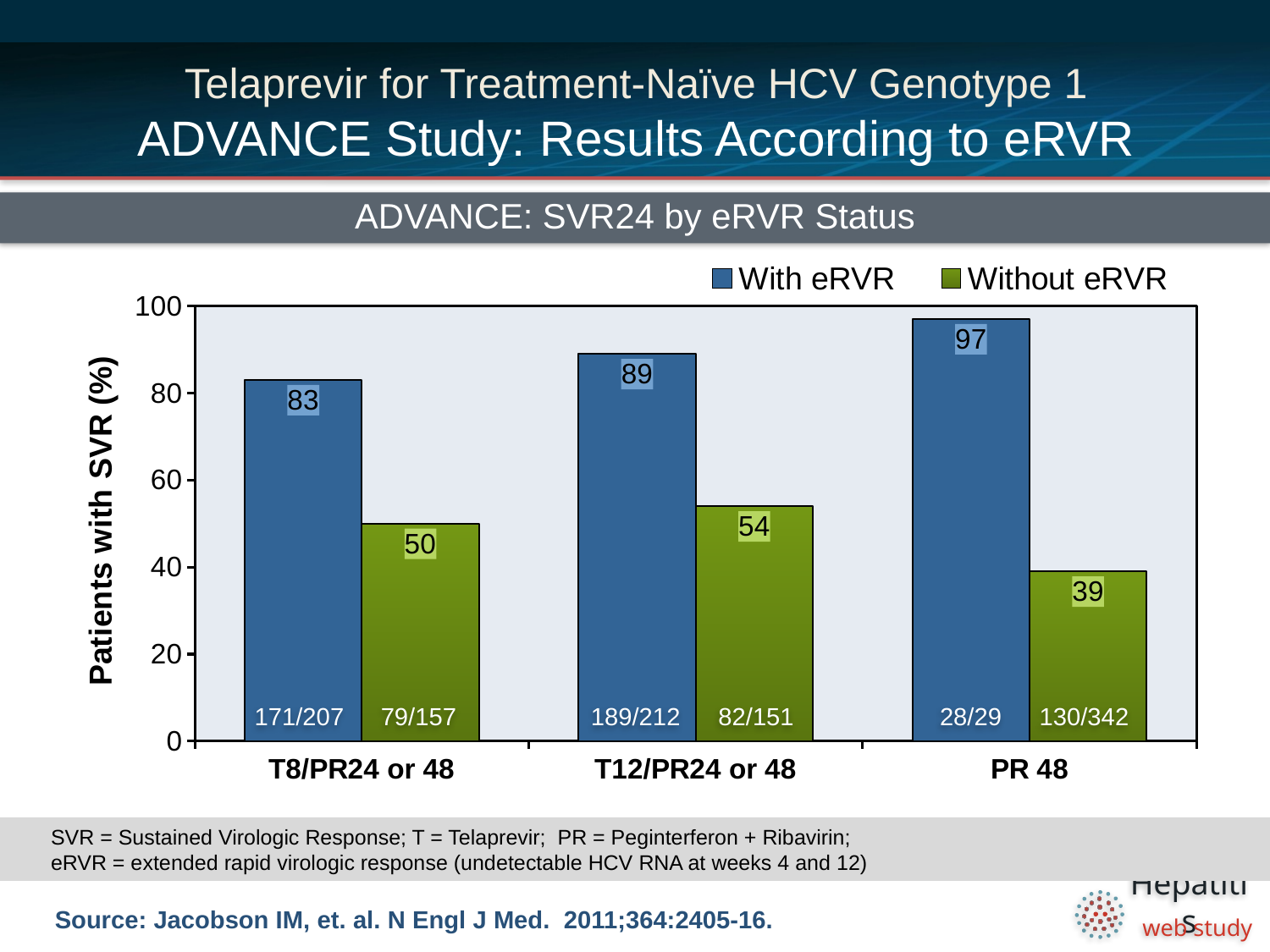
What is the SVR rate for patients with eRVR in the T12/PR24 or 48 group? 89 What is the title of the chart? ADVANCE: SVR24 by eRVR Status What is the difference between the With eRVR and Without eRVR SVR rates in the PR 48 group? 58 How many series does the legend list? 2 What fraction is printed on the With eRVR bar for the PR 48 group? 28/29 Which treatment group has the highest SVR rate among patients with eRVR? PR 48 Which is larger: the Without eRVR SVR rate for T8/PR24 or 48 or for T12/PR24 or 48? T12/PR24 or 48 How many treatment groups are shown on the x axis? 3 What kind of chart is shown on the slide? Bar chart What is the SVR rate for patients with eRVR in the T8/PR24 or 48 group? 83 Which treatment group has the lowest SVR rate among patients without eRVR? PR 48 What is the SVR rate for patients without eRVR in the PR 48 group? 39